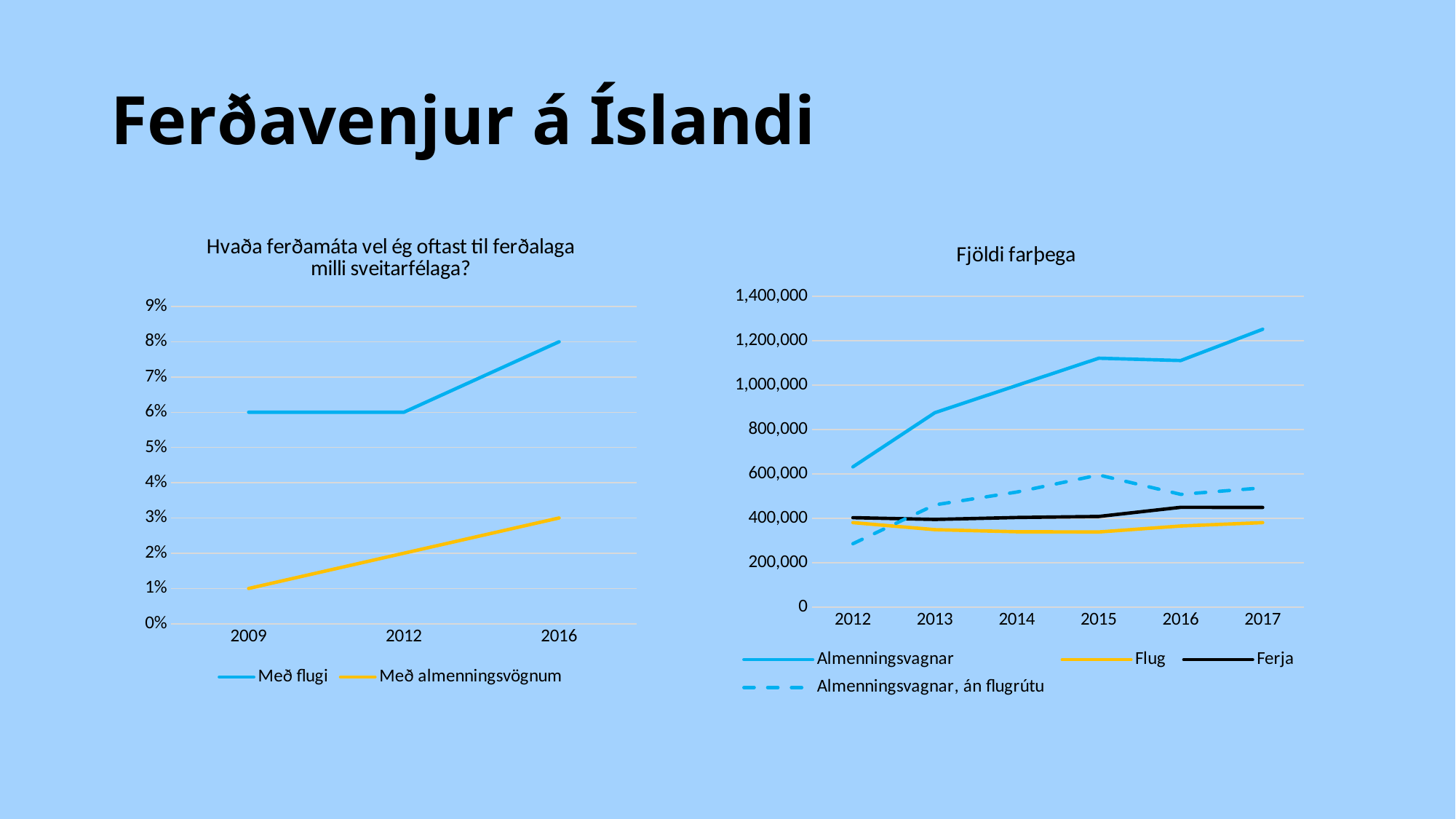
In the right chart "Fjöldi farþega", which is larger in 2012: Ferja or Almenningsvagnar, án flugrútu? Ferja In the right chart "Fjöldi farþega", is the value for Almenningsvagnar in 2017 greater or less than 1,200,000? greater In the right chart titled "Fjöldi farþega", how many series does the legend list? 4 In the right chart "Fjöldi farþega", which series has the highest value in 2017? Almenningsvagnar In the left chart, what is the value for Með flugi in 2016? 8% In the right chart "Fjöldi farþega", which series is drawn with a dashed line? Almenningsvagnar, án flugrútu What kind of chart is the left chart titled "Hvaða ferðamáta vel ég oftast til ferðalaga milli sveitarfélaga?"? Line chart In the left chart, how many years are shown on the x axis? 3 In the left chart, does the Með almenningsvögnum line rise or fall from 2009 to 2016? Rise In the left chart, what is the difference between Með flugi and Með almenningsvögnum in 2016? 5% In the left chart, what is the value for Með almenningsvögnum in 2009? 1% In the right chart "Fjöldi farþega", is the value for Flug in 2015 greater or less than 400,000? less